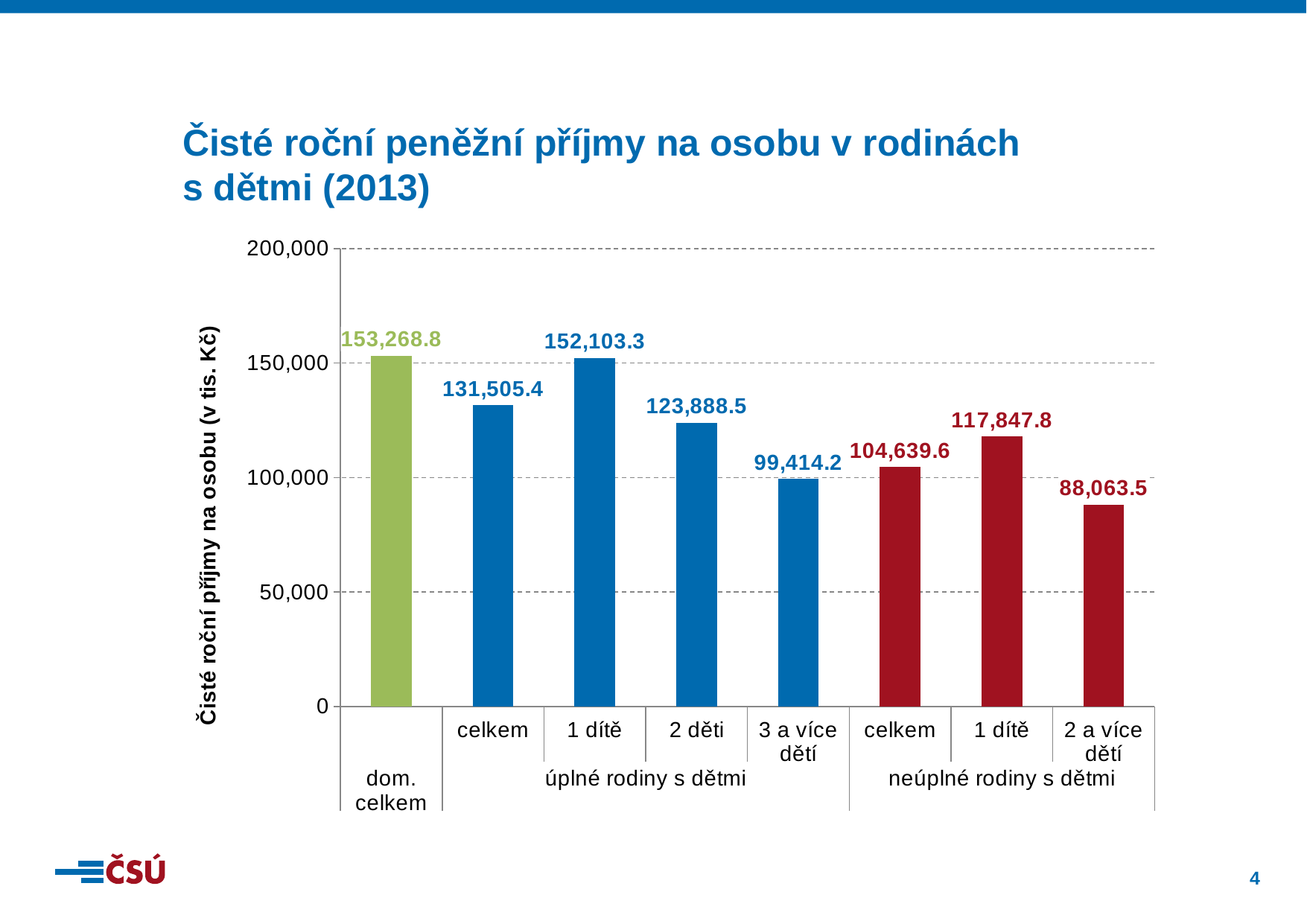
What kind of chart is shown on the slide? bar chart Which is larger: '1 dítě' in úplné rodiny s dětmi or '1 dítě' in neúplné rodiny s dětmi? 1 dítě in úplné rodiny s dětmi Which category has the lowest value? 2 a více dětí (neúplné rodiny s dětmi) Which category has the highest value? dom. celkem What is the value for 'dom. celkem'? 153,268.8 What is the value for '1 dítě' in the 'neúplné rodiny s dětmi' group? 117,847.8 Is the value for '2 děti' in úplné rodiny s dětmi greater or less than 100,000? greater How many bars are plotted in the chart? 8 What is the label of the vertical axis? Čisté roční příjmy na osobu (v tis. Kč) What is the difference between 'celkem' for úplné rodiny s dětmi and 'celkem' for neúplné rodiny s dětmi? 26,865.8 What is the value for '3 a více dětí' in the 'úplné rodiny s dětmi' group? 99,414.2